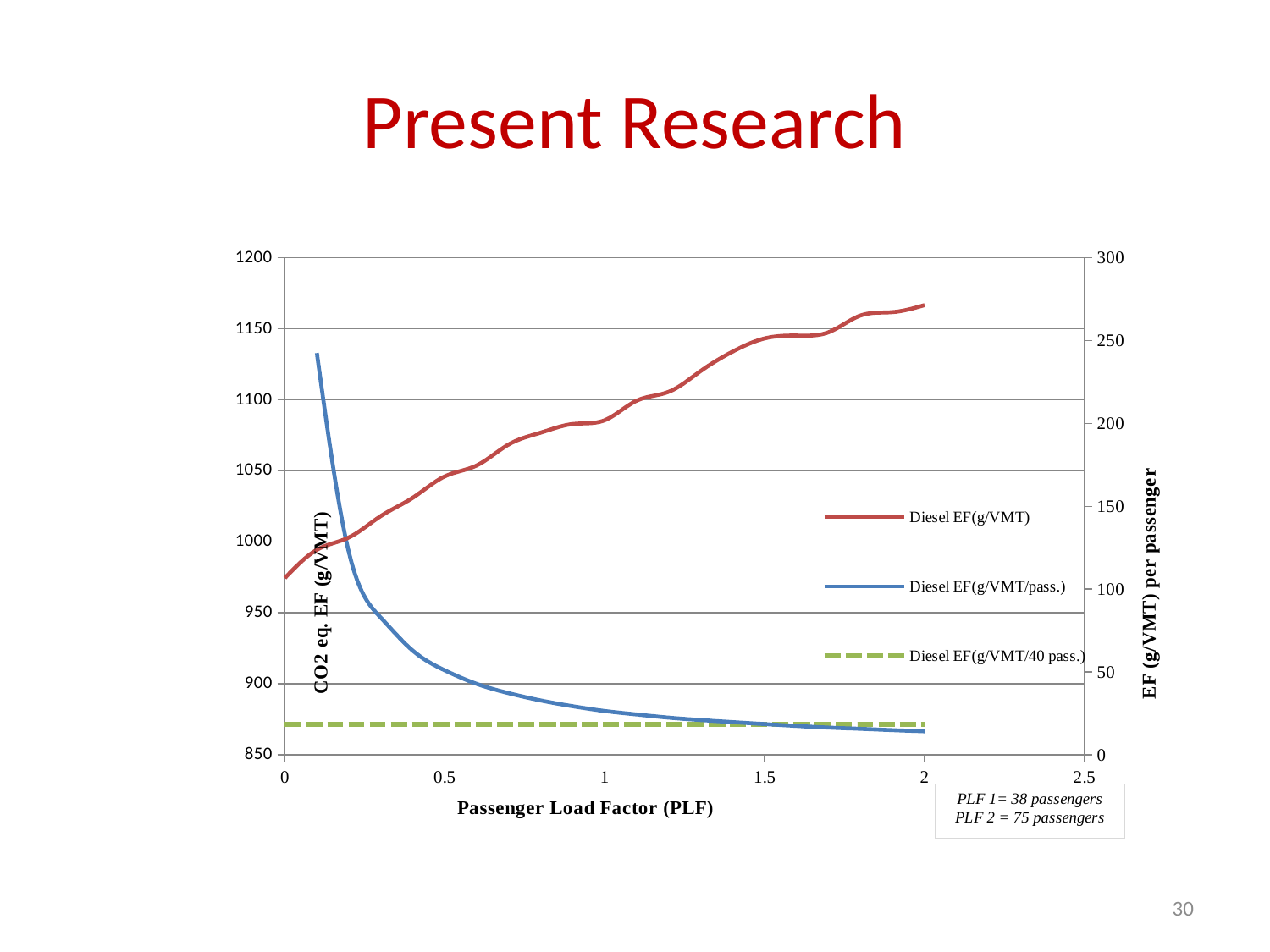
Is the Diesel EF(g/VMT) value at a Passenger Load Factor of 1 greater or less than 1050 on the left axis? greater Which series is higher at a Passenger Load Factor of 0.5, Diesel EF(g/VMT/pass.) or Diesel EF(g/VMT/40 pass.)? Diesel EF(g/VMT/pass.) Does the Diesel EF(g/VMT/pass.) series rise or fall as the Passenger Load Factor increases? fall Does the Diesel EF(g/VMT/40 pass.) series rise, fall or stay flat across the Passenger Load Factor range? stay flat Does the Diesel EF(g/VMT) series rise or fall as the Passenger Load Factor increases? rise What kind of chart is shown on the slide? line chart Is the Diesel EF(g/VMT) value at a Passenger Load Factor of 2 greater or less than 1150 on the left axis? greater Is the Diesel EF(g/VMT) value at a Passenger Load Factor of 0.5 greater or less than 1100 on the left axis? less What is the title of the x axis? Passenger Load Factor (PLF) According to the note on the chart, how many passengers does PLF 2 correspond to? 75 passengers How many series does the legend list? 3